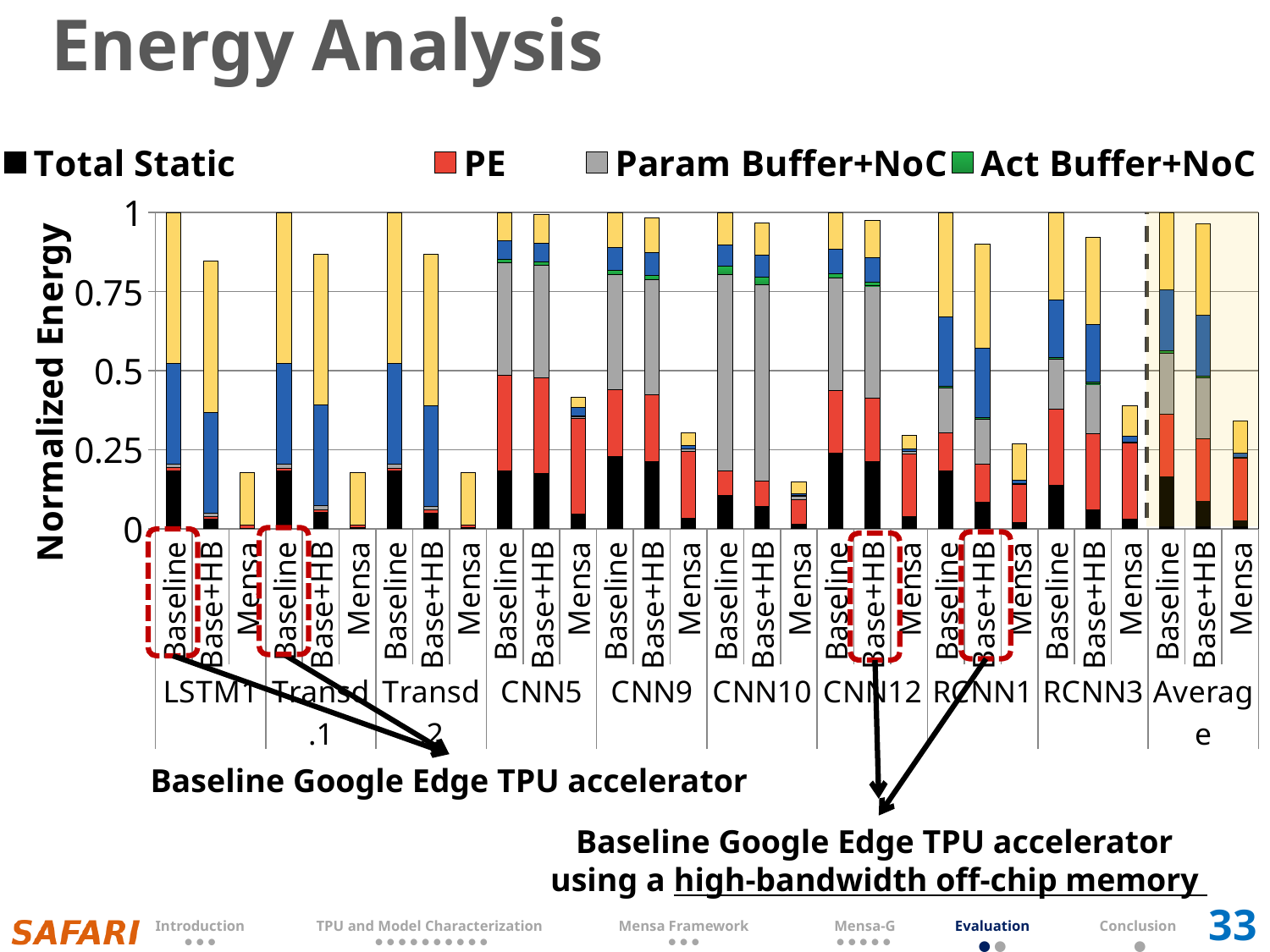
Is the total normalized energy for Mensa in LSTM1 greater or less than 0.25? less Is the total normalized energy for Mensa in the Average group greater or less than 0.5? less In the CNN10 group, which has the larger total normalized energy: Base+HB or Mensa? Base+HB Within the RCNN3 group, which configuration has the highest total normalized energy? Baseline How many entries does the chart's legend list? 4 Within the CNN12 group, which configuration has the lowest total normalized energy? Mensa Is the total normalized energy for Base+HB in LSTM1 greater or less than 0.75? greater What is the label of the chart's y axis? Normalized Energy What kind of chart is shown on the slide? stacked bar chart What is the normalized energy of the Baseline bar for LSTM1? 1 How many workload groups are shown along the x axis of the chart? 10